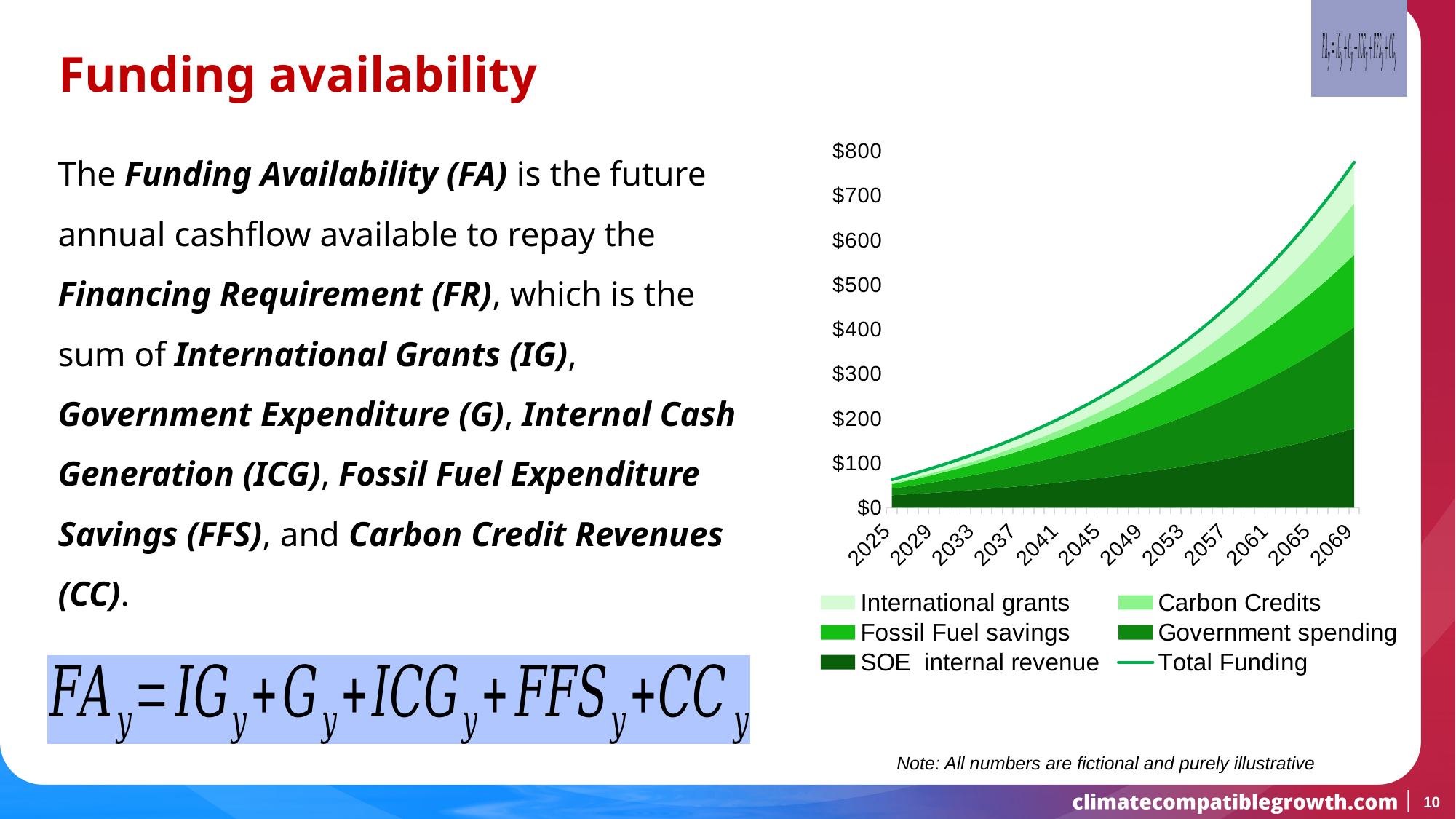
Is the Total Funding value for 2045 greater or less than $200? greater What kind of chart is shown on the slide? Stacked area chart with a line Which series is plotted as a line rather than a filled area? Total Funding In which year is Total Funding lowest? 2025 Is the Total Funding value for 2057 greater or less than $400? greater Is the Total Funding value for 2069 greater or less than $700? greater How many year labels are shown on the x axis? 12 Does Total Funding rise or fall from 2025 to 2069? Rises Which series is shown in the darkest green at the bottom of the stack? SOE internal revenue How many series does the chart's legend list? 6